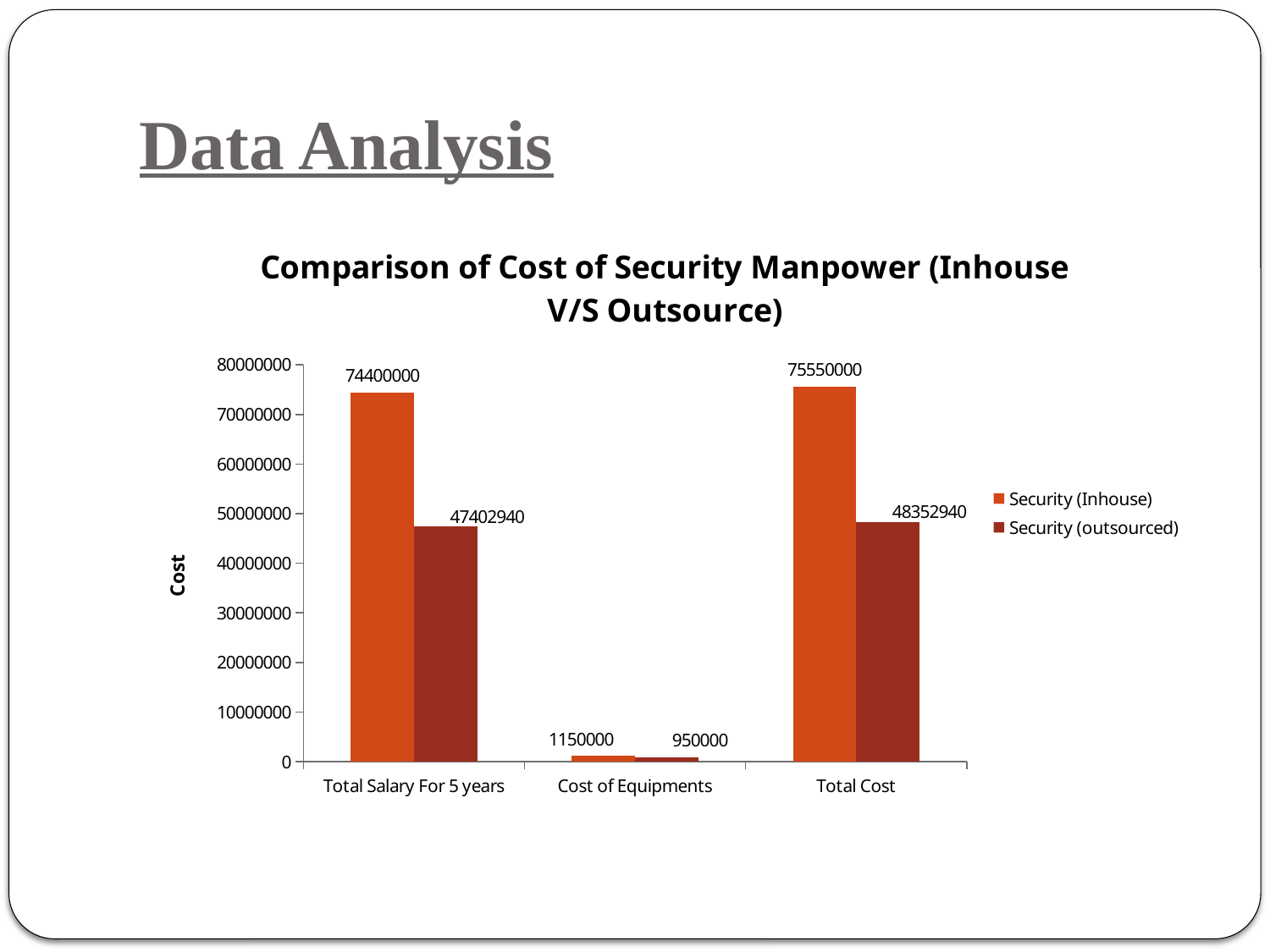
Which category has the highest value for Security (Inhouse)? Total Cost What is the value for Security (outsourced) in the Total Cost category? 48352940 What is the value for Security (Inhouse) in the Cost of Equipments category? 1150000 What kind of chart is shown on the slide? bar chart What is the value for Security (Inhouse) in the Total Salary For 5 years category? 74400000 Which category has the lowest value for Security (outsourced)? Cost of Equipments How many categories are shown on the x axis? 3 What is the difference between Security (Inhouse) and Security (outsourced) in the Total Cost category? 27197060 Is the value for Security (outsourced) in the Total Salary For 5 years category greater or less than 50000000? less How many series does the legend list? 2 Which is larger in the Total Salary For 5 years category: Security (Inhouse) or Security (outsourced)? Security (Inhouse) What is the value for Security (outsourced) in the Cost of Equipments category? 950000